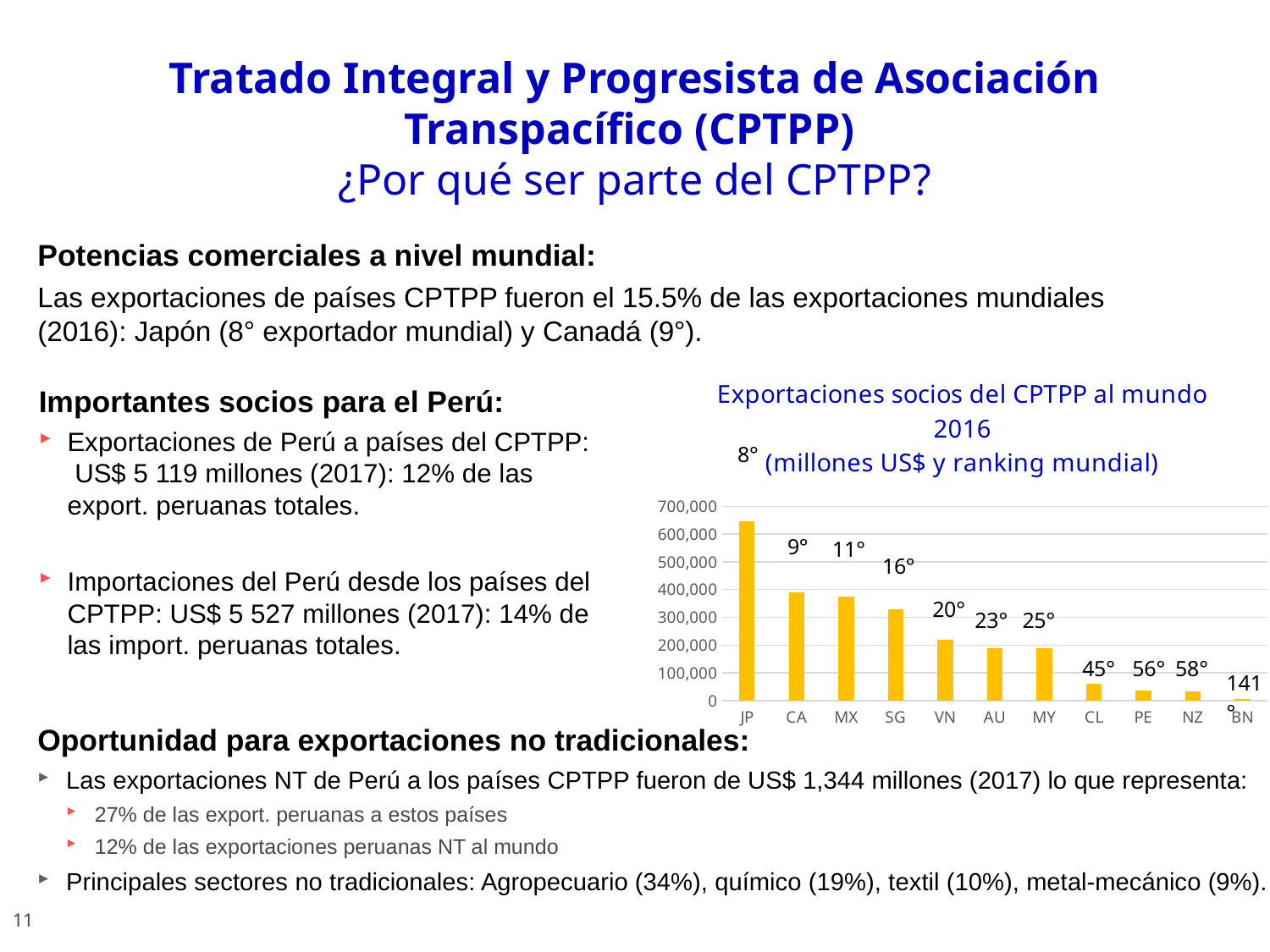
Is the value for JP greater or less than 600,000? greater Which has a larger value, CA or VN? CA Is the value for SG greater or less than 300,000? greater What world ranking label is shown above the bar for JP? 8° Is the value for CL greater or less than 100,000? less Do the bar values rise or fall from left to right along the x axis? Fall Which country has the lowest exports in the chart? BN What world ranking label is shown above the bar for PE? 56° What kind of chart is shown on the slide? Bar chart What world ranking label is shown above the bar for BN? 141° How many countries are shown on the x axis of the chart? 11 Which country has the highest exports in the chart? JP